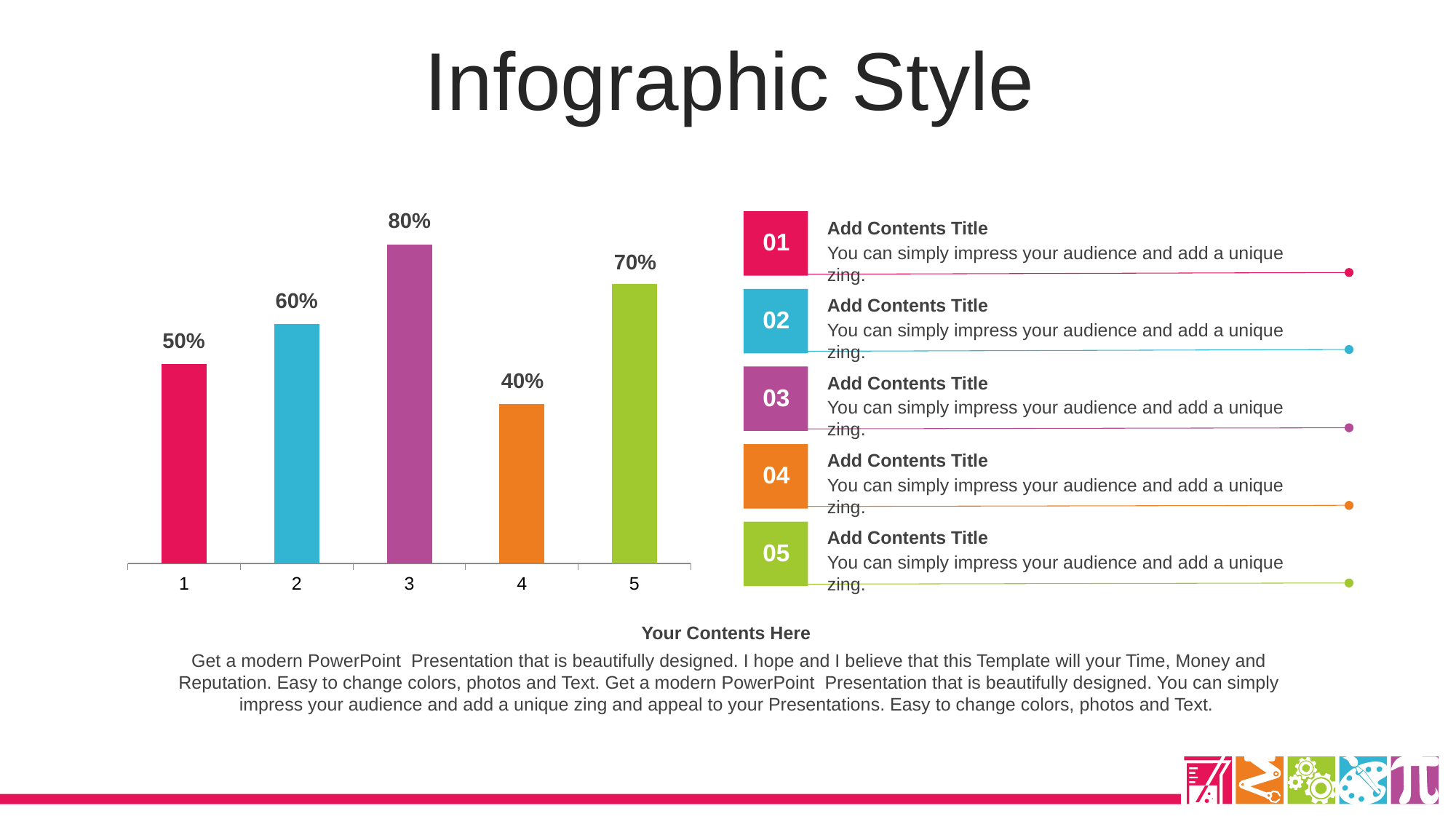
What is the value for category 3? 80% What is the value for category 5? 70% What is the value for category 1? 50% What kind of chart is shown on the slide? bar chart What is the value for category 4? 40% What is the difference between the values for category 2 and category 1? 10% Which is larger, the value for category 2 or the value for category 5? 5 What is the difference between the values for category 3 and category 4? 40% Which category has the highest value? 3 What colour is the bar for category 3? purple Which category has the lowest value? 4 How many categories are shown on the x axis? 5